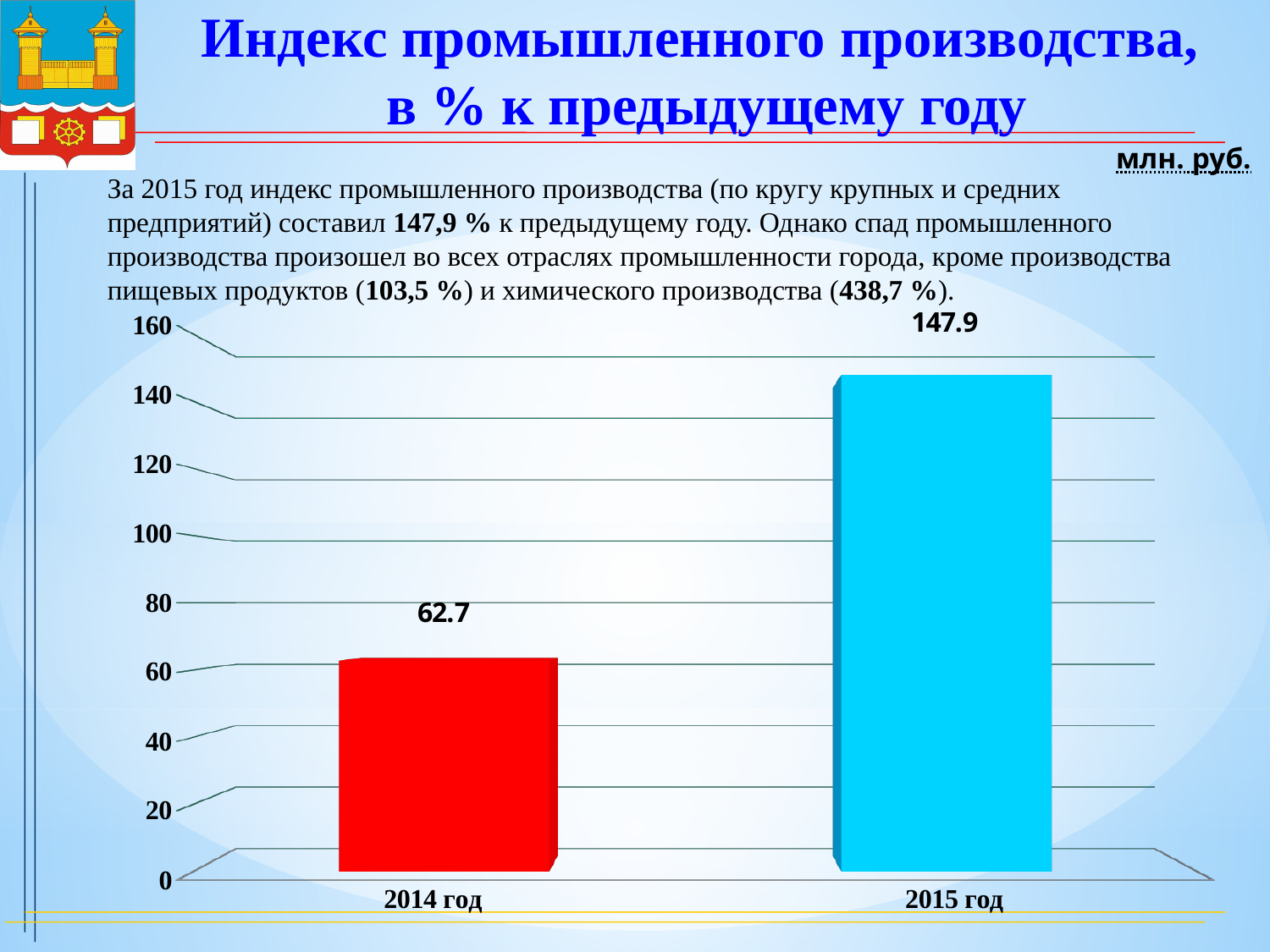
Is the value for 2015 год greater or less than 140? greater What is the difference between the values for 2015 год and 2014 год? 85.2 How many categories are shown on the x axis? 2 Do the values rise or fall from 2014 год to 2015 год? rise What is the value shown for 2015 год? 147.9 What is the value shown for 2014 год? 62.7 What colour is the bar for 2014 год? red Is the value for 2014 год larger or smaller than the value for 2015 год? smaller What kind of chart is shown on the slide? bar chart Which year has the higher value? 2015 год Is the value for 2014 год greater or less than 80? less Which year has the lower value? 2014 год